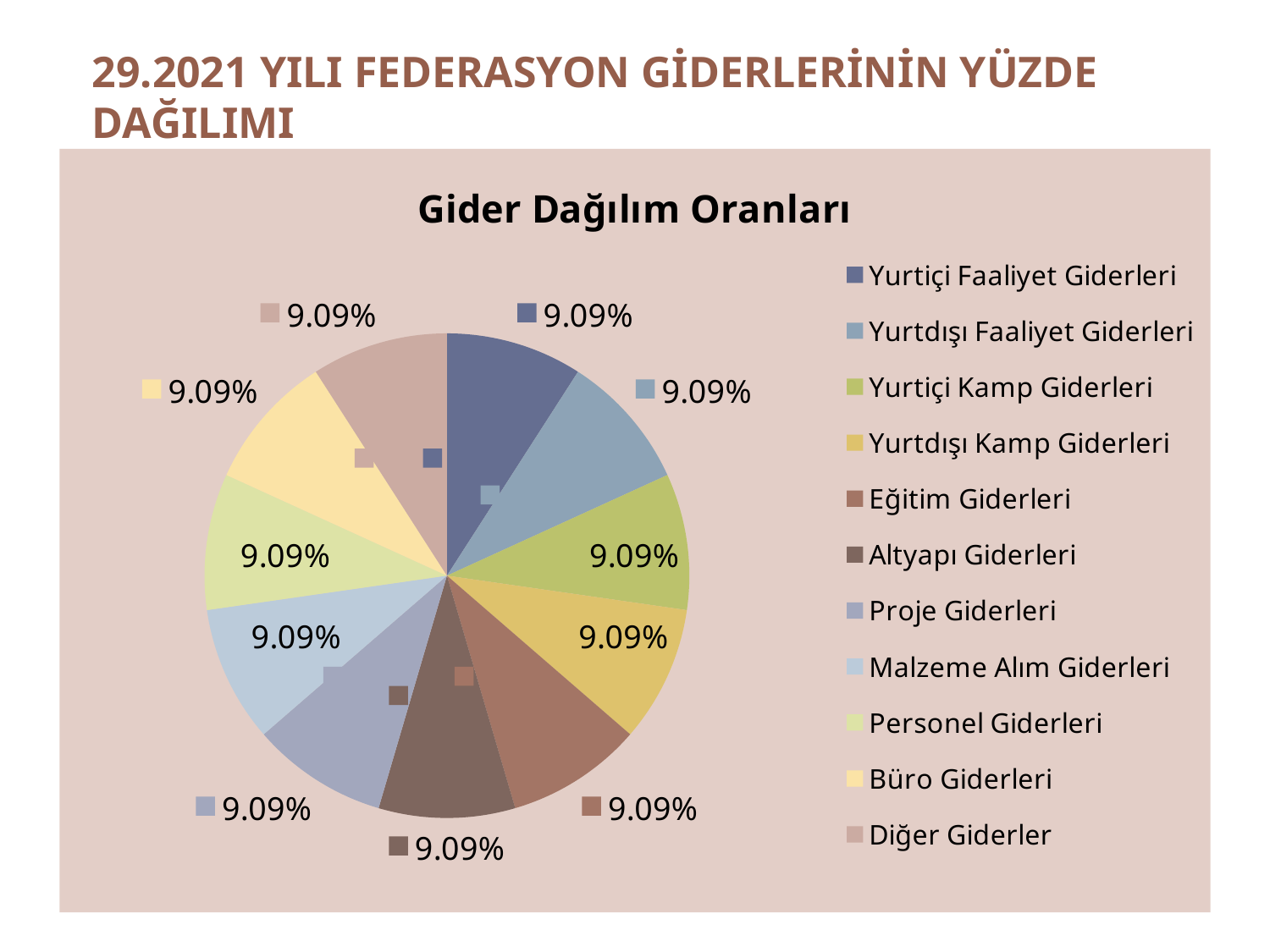
What share of the pie does Yurtiçi Faaliyet Giderleri represent? 9.09% What share of the pie does Altyapı Giderleri represent? 9.09% How many categories does the legend of the pie chart list? 11 What is the value shown for Eğitim Giderleri? 9.09% What is the value shown for Diğer Giderler? 9.09% What is the value shown for Personel Giderleri? 9.09% Is the share for Büro Giderleri larger than, smaller than, or equal to the share for Proje Giderleri? equal What is the value shown for Malzeme Alım Giderleri? 9.09% What share of the pie does Yurtdışı Kamp Giderleri represent? 9.09% What is the title of the chart? Gider Dağılım Oranları Do all slices of the pie chart have the same percentage value? yes What kind of chart is shown on the slide? pie chart